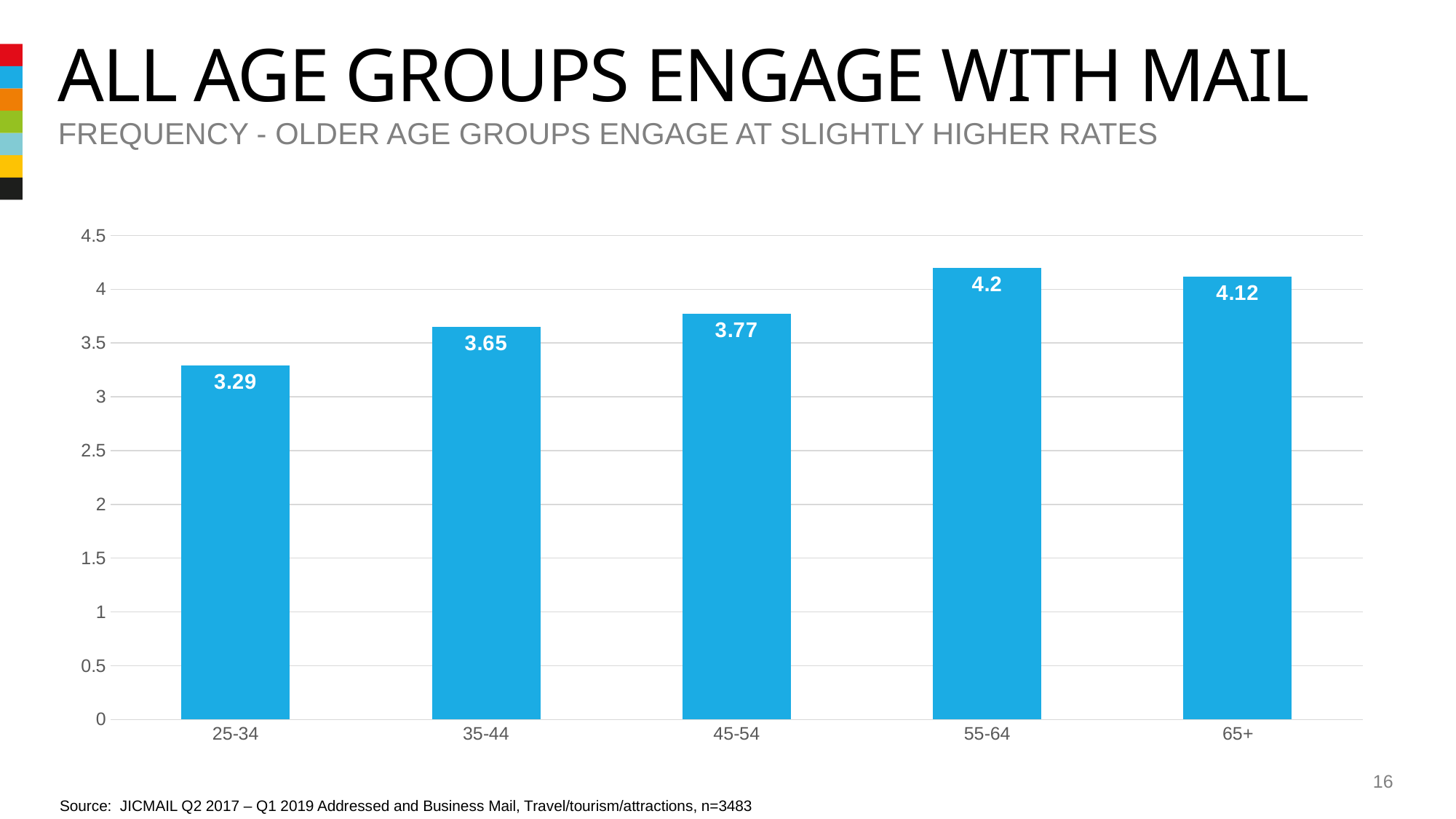
Which age group has the lowest value? 25-34 Do the values rise or fall from 25-34 to 55-64? rise What is the difference between the values for 55-64 and 25-34? 0.91 What is the difference between the values for 45-54 and 35-44? 0.12 What is the value for the 25-34 age group? 3.29 Which age group has the highest value? 55-64 Which has a larger value, 35-44 or 45-54? 45-54 What is the value for the 65+ age group? 4.12 Is the value for 45-54 greater or less than 4? less What kind of chart is shown on the slide? bar chart What is the value for the 55-64 age group? 4.2 How many age groups are shown on the chart? 5